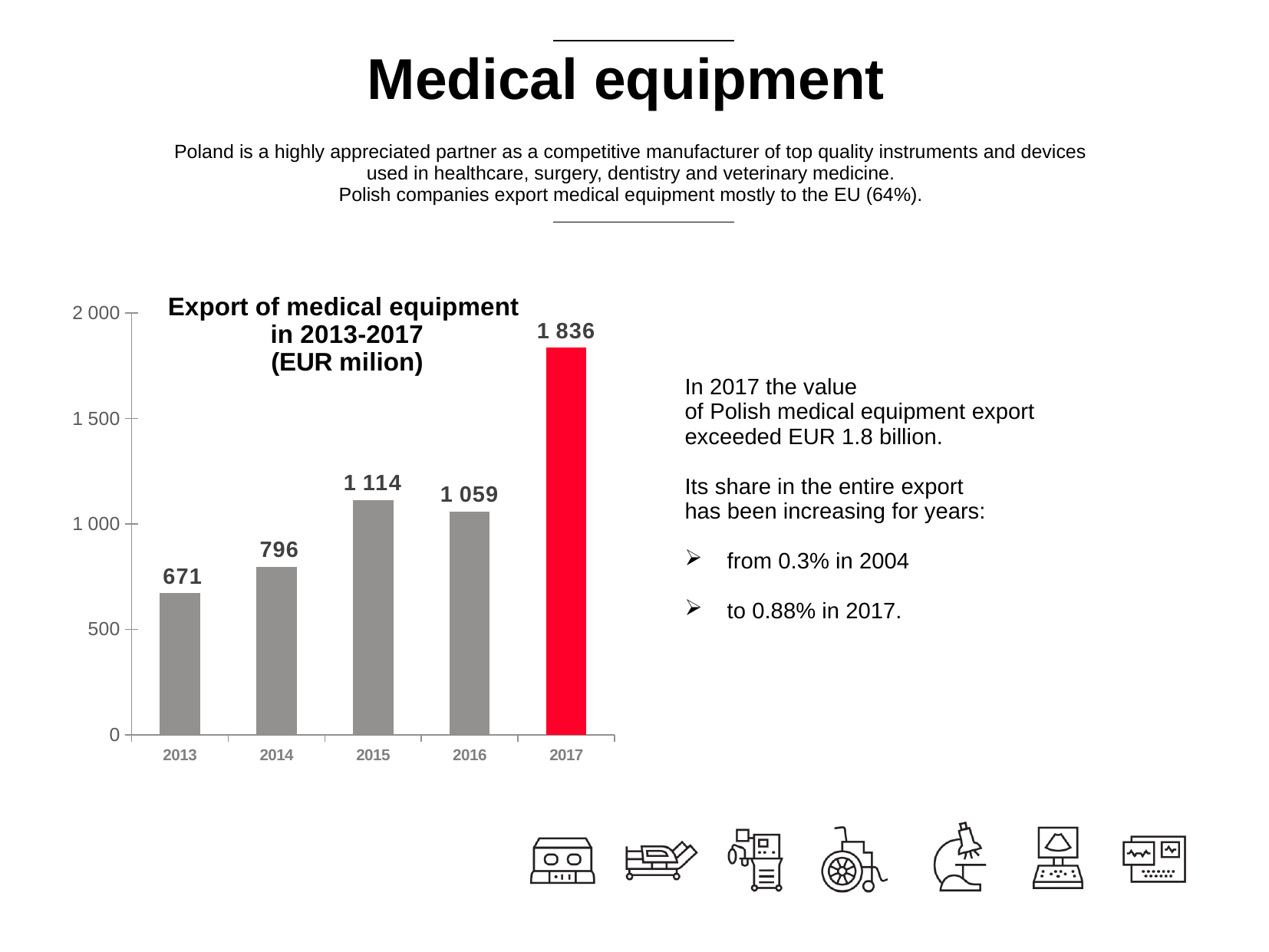
What was the export of medical equipment in 2015? 1 114 What is the difference between the export values for 2014 and 2013? 125 What kind of chart is shown on the slide? bar chart What is the difference between the export values for 2017 and 2016? 777 Is the export value for 2014 greater or less than 1 000? less Which year has the lowest export value? 2013 How many years are shown on the chart? 5 What was the export of medical equipment in 2013? 671 Which bar is coloured red on the chart? 2017 Which year has the larger export value, 2015 or 2016? 2015 Which year has the highest export value? 2017 What was the export of medical equipment in 2017? 1 836